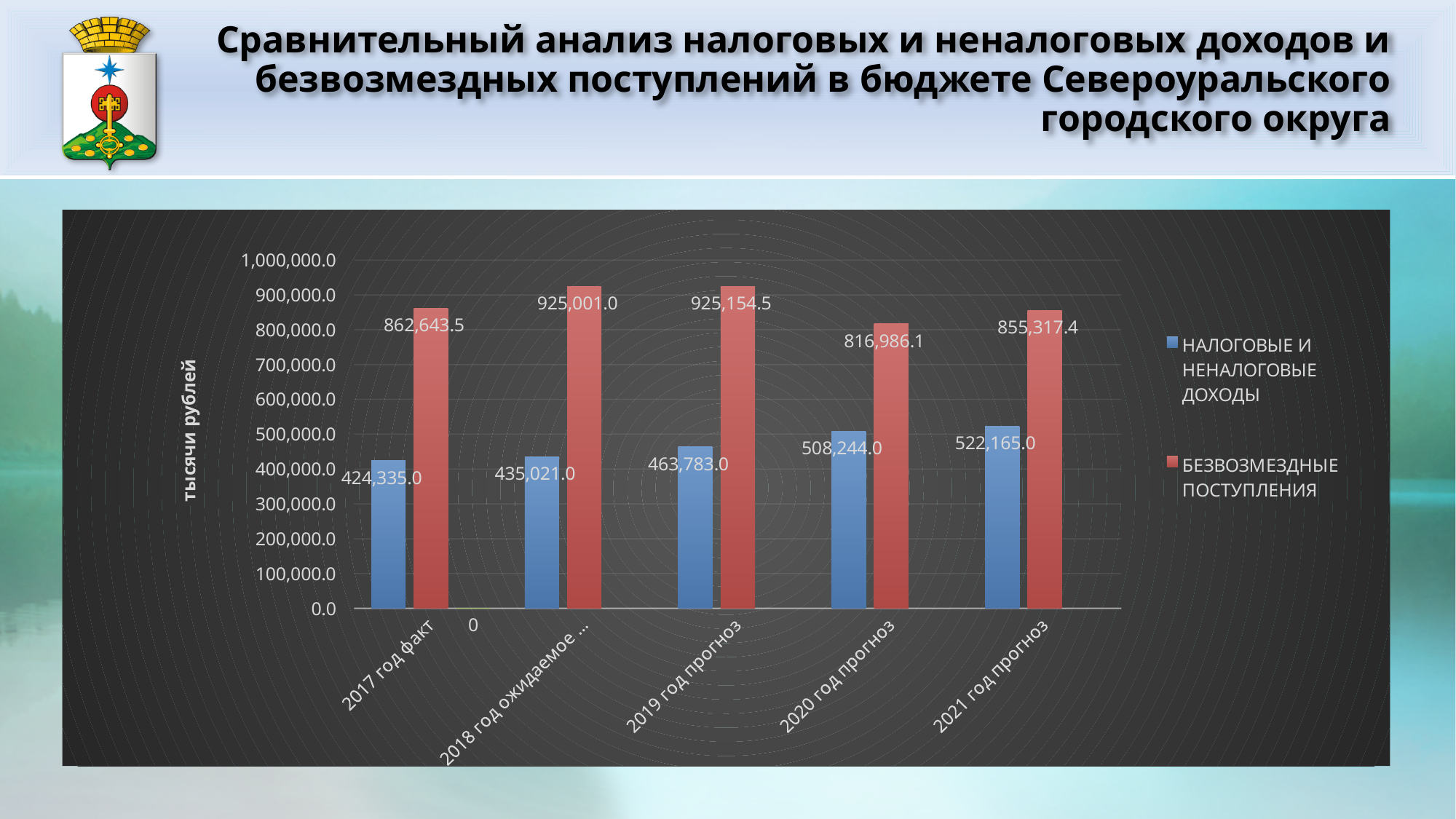
Do the values of НАЛОГОВЫЕ И НЕНАЛОГОВЫЕ ДОХОДЫ rise or fall from 2017 to 2021? rise What kind of chart is shown on the slide? bar chart How many series does the legend list? 2 What is the value of НАЛОГОВЫЕ И НЕНАЛОГОВЫЕ ДОХОДЫ for 2017 год факт? 424,335.0 How many categories are shown on the x axis of the chart? 5 What is the value of БЕЗВОЗМЕЗДНЫЕ ПОСТУПЛЕНИЯ for 2021 год прогноз? 855,317.4 What is the value of БЕЗВОЗМЕЗДНЫЕ ПОСТУПЛЕНИЯ for 2020 год прогноз? 816,986.1 Which is larger for 2020 год прогноз: НАЛОГОВЫЕ И НЕНАЛОГОВЫЕ ДОХОДЫ or БЕЗВОЗМЕЗДНЫЕ ПОСТУПЛЕНИЯ? БЕЗВОЗМЕЗДНЫЕ ПОСТУПЛЕНИЯ What is the difference between БЕЗВОЗМЕЗДНЫЕ ПОСТУПЛЕНИЯ and НАЛОГОВЫЕ И НЕНАЛОГОВЫЕ ДОХОДЫ for 2017 год факт? 438,308.5 In which category is БЕЗВОЗМЕЗДНЫЕ ПОСТУПЛЕНИЯ lowest? 2020 год прогноз In which category is НАЛОГОВЫЕ И НЕНАЛОГОВЫЕ ДОХОДЫ highest? 2021 год прогноз What is the value of НАЛОГОВЫЕ И НЕНАЛОГОВЫЕ ДОХОДЫ for 2019 год прогноз? 463,783.0